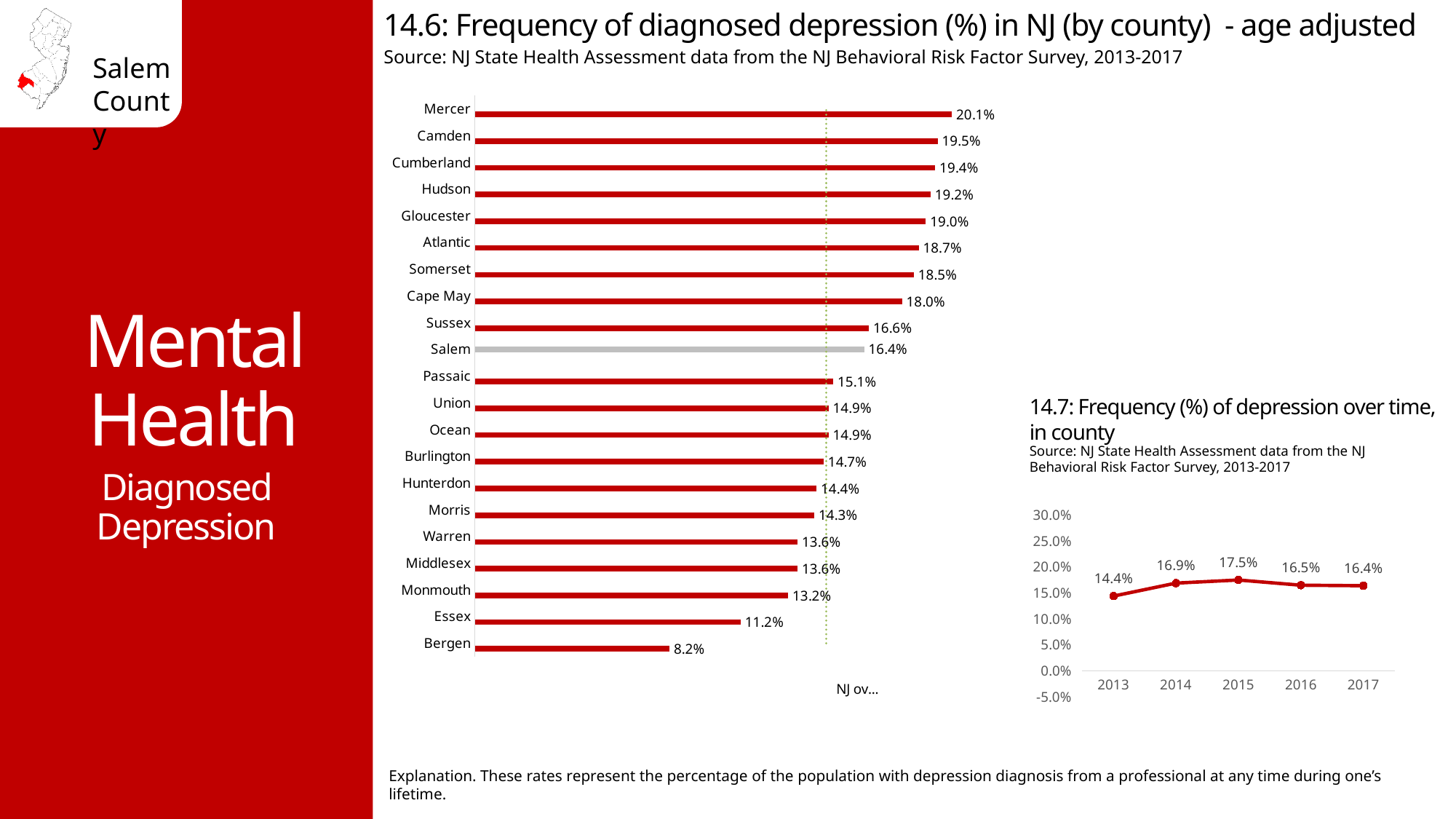
In chart 14.6 (Frequency of diagnosed depression by county), how many counties are plotted? 21 What kind of chart is chart 14.6 (Frequency of diagnosed depression by county)? Bar chart In chart 14.6 (Frequency of diagnosed depression by county), what is the value for Essex? 11.2% In chart 14.6 (Frequency of diagnosed depression by county), which county has the lowest value? Bergen In chart 14.6 (Frequency of diagnosed depression by county), which county has the highest value? Mercer In chart 14.7 (Frequency of depression over time, in county), what is the value for 2015? 17.5% In chart 14.7 (Frequency of depression over time, in county), which year has the lowest value? 2013 What kind of chart is chart 14.7 (Frequency of depression over time, in county)? Line chart In chart 14.6 (Frequency of diagnosed depression by county), which is larger, the value for Cape May or the value for Passaic? Cape May In chart 14.7 (Frequency of depression over time, in county), what is the difference between the 2015 and 2013 values? 3.1% In chart 14.6 (Frequency of diagnosed depression by county), what is the difference between Mercer and Bergen? 11.9% In chart 14.6 (Frequency of diagnosed depression by county), what is the value for Salem? 16.4%